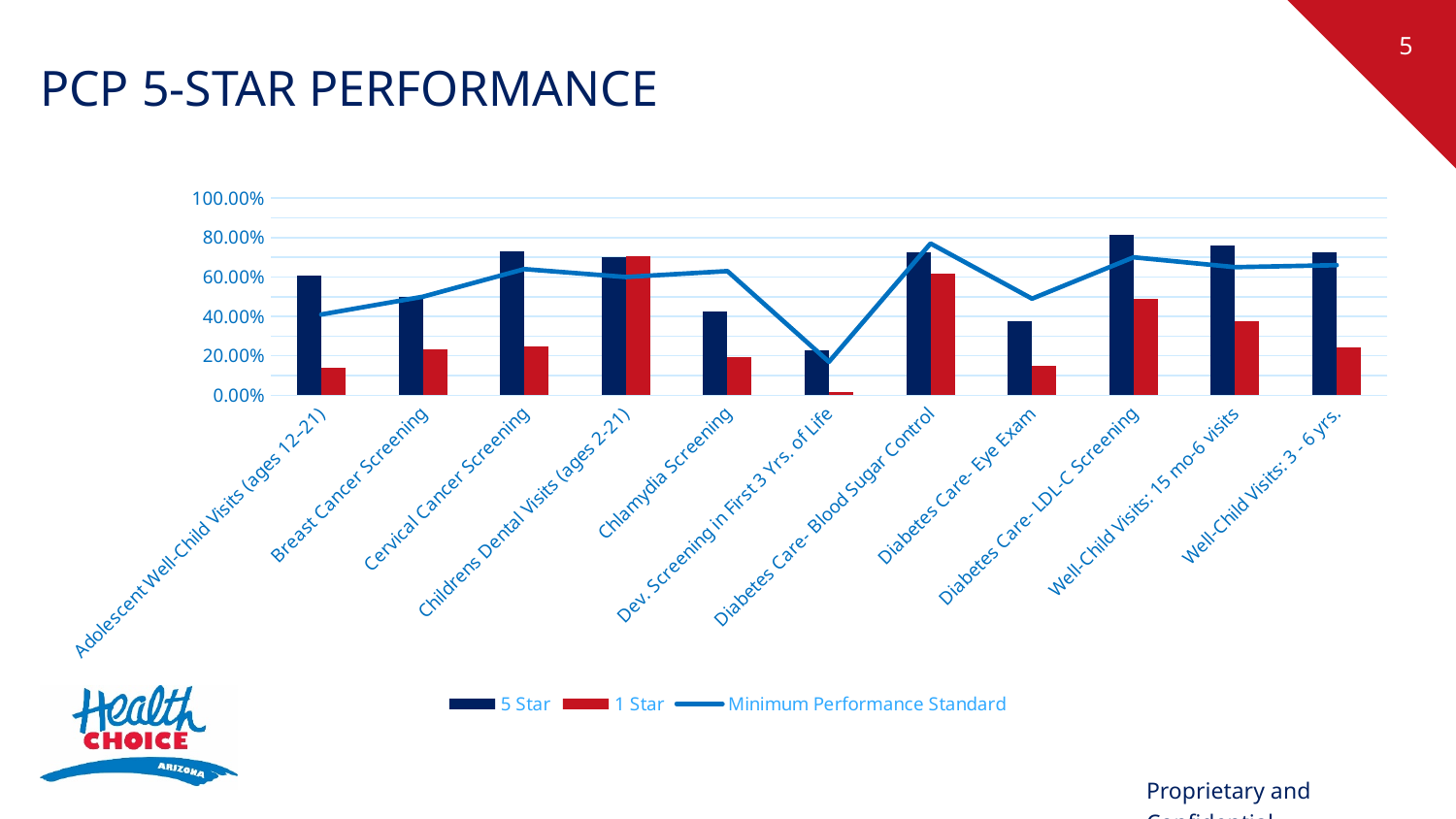
Which category has the lowest 1 Star value? Dev. Screening in First 3 Yrs. of Life Which category has the lowest 5 Star value? Dev. Screening in First 3 Yrs. of Life What is the title of the chart slide? PCP 5-STAR PERFORMANCE For Chlamydia Screening, which is larger: the 5 Star value or the 1 Star value? 5 Star Is the 5 Star value for Chlamydia Screening greater or less than 60.00%? less How many series does the chart legend list? 3 Which category has the highest 1 Star value? Childrens Dental Visits (ages 2-21) Is the 1 Star value for Diabetes Care- Blood Sugar Control greater or less than 40.00%? greater Is the 5 Star value for Adolescent Well-Child Visits (ages 12-21) greater or less than 40.00%? greater Which category has the highest 5 Star value? Diabetes Care- LDL-C Screening How many categories are shown on the x axis of the chart? 11 What kind of chart is used to plot the 5 Star and 1 Star series? bar chart